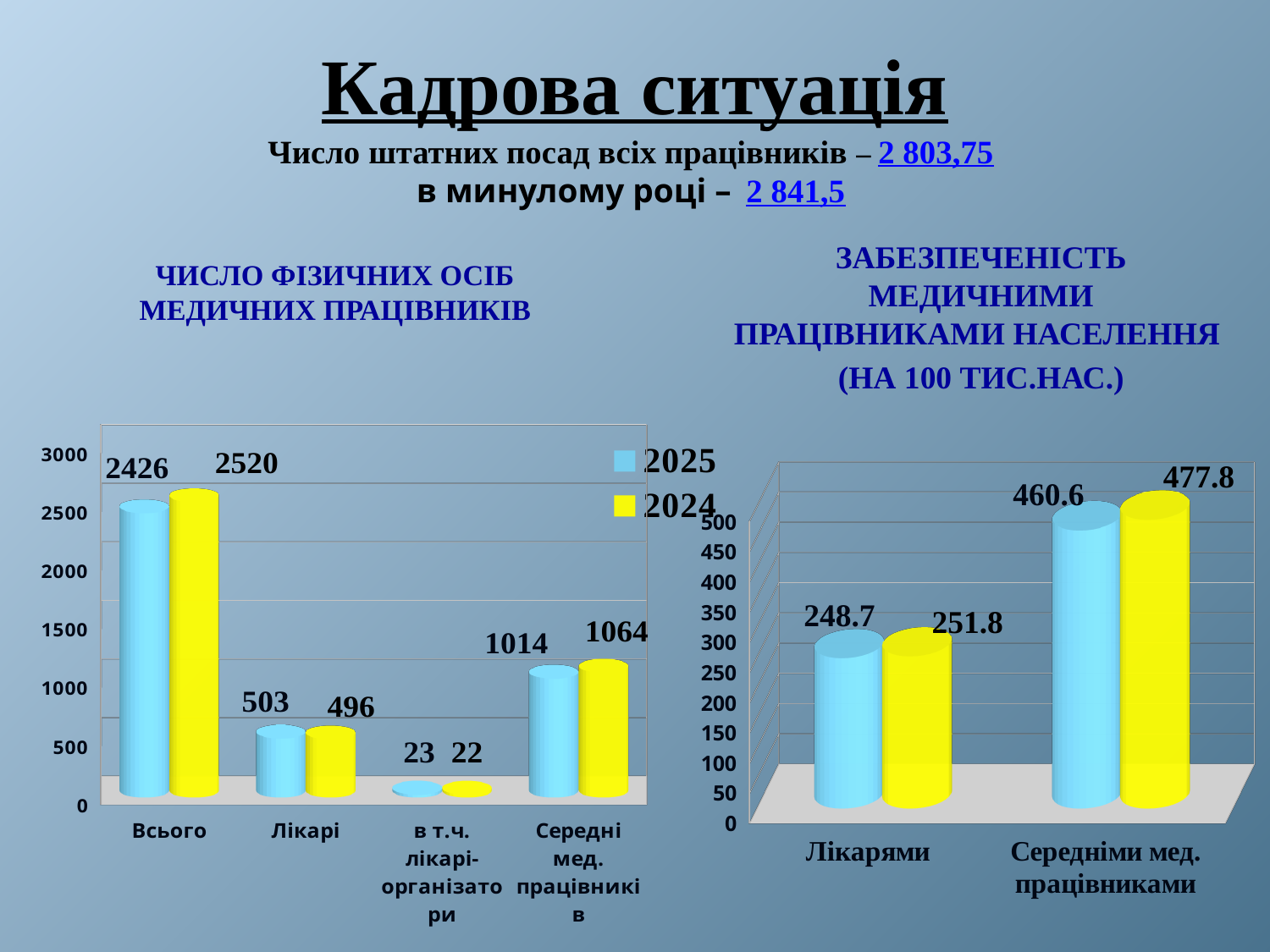
In the right chart, what is the value of the blue bar for Лікарями? 248.7 What kind of chart is the right chart? Bar chart In the right chart, what is the difference between the yellow and blue bars for Середніми мед. працівниками? 17.2 How many categories are shown on the x axis of the left chart? 4 In the left chart, which category has the lowest values? в т.ч. лікарі-організатори How many series does the legend of the left chart list? 2 In the left chart, which is larger for Лікарі: the 2025 value or the 2024 value? 2025 In the right chart (ЗАБЕЗПЕЧЕНІСТЬ МЕДИЧНИМИ ПРАЦІВНИКАМИ НАСЕЛЕННЯ), what is the value of the yellow bar for Середніми мед. працівниками? 477.8 In the left chart, what is the value for Лікарі in 2025? 503 In the left chart, what is the value for Середні мед. працівники in 2024? 1064 In the left chart (ЧИСЛО ФІЗИЧНИХ ОСІБ МЕДИЧНИХ ПРАЦІВНИКІВ), what is the value for Всього in 2025? 2426 In the left chart, what is the difference between the 2024 and 2025 values for Всього? 94